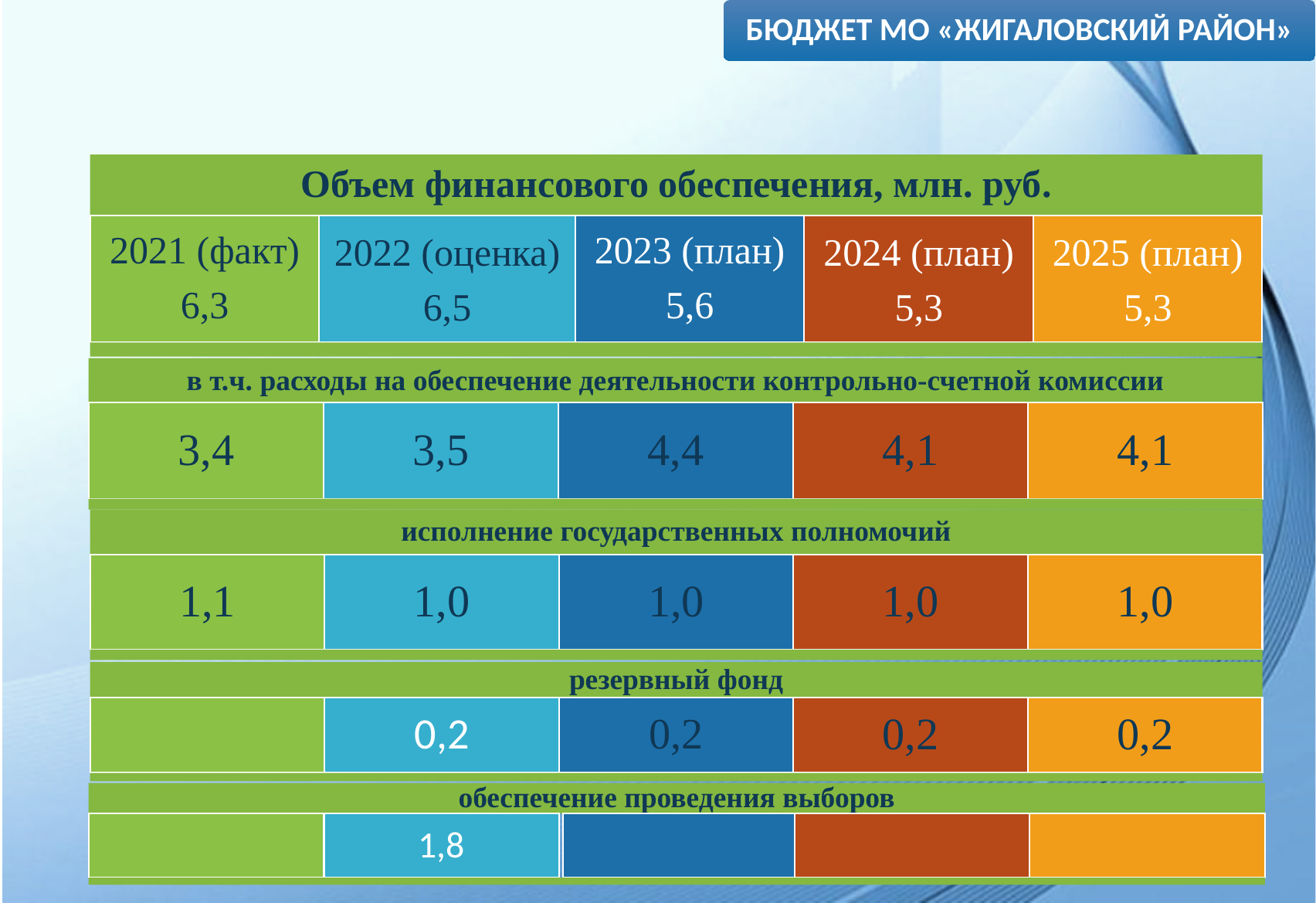
What is the planned volume of financial support for 2023? 5,6 What is the difference between the total volume of financial support in 2022 (оценка) and 2021 (факт)? 0,2 What is the value of the reserve fund (резервный фонд) for 2025 (план)? 0,2 Which is larger: the value for исполнение государственных полномочий in 2021 or in 2022? 2021 What is the total volume of financial support for 2022 (оценка)? 6,5 Which year has the lowest value for expenses on the control and accounting commission? 2021 (факт) How many years (columns) are shown in the table? 5 Which year has the highest total volume of financial support? 2022 (оценка) What is the total volume of financial support (Объем финансового обеспечения) for 2021 (факт)? 6,3 What is the value for обеспечение проведения выборов in 2022 (оценка)? 1,8 In what units are the values in the table given? млн. руб. What is the value for expenses on the control and accounting commission (контрольно-счетной комиссии) in 2023 (план)? 4,4